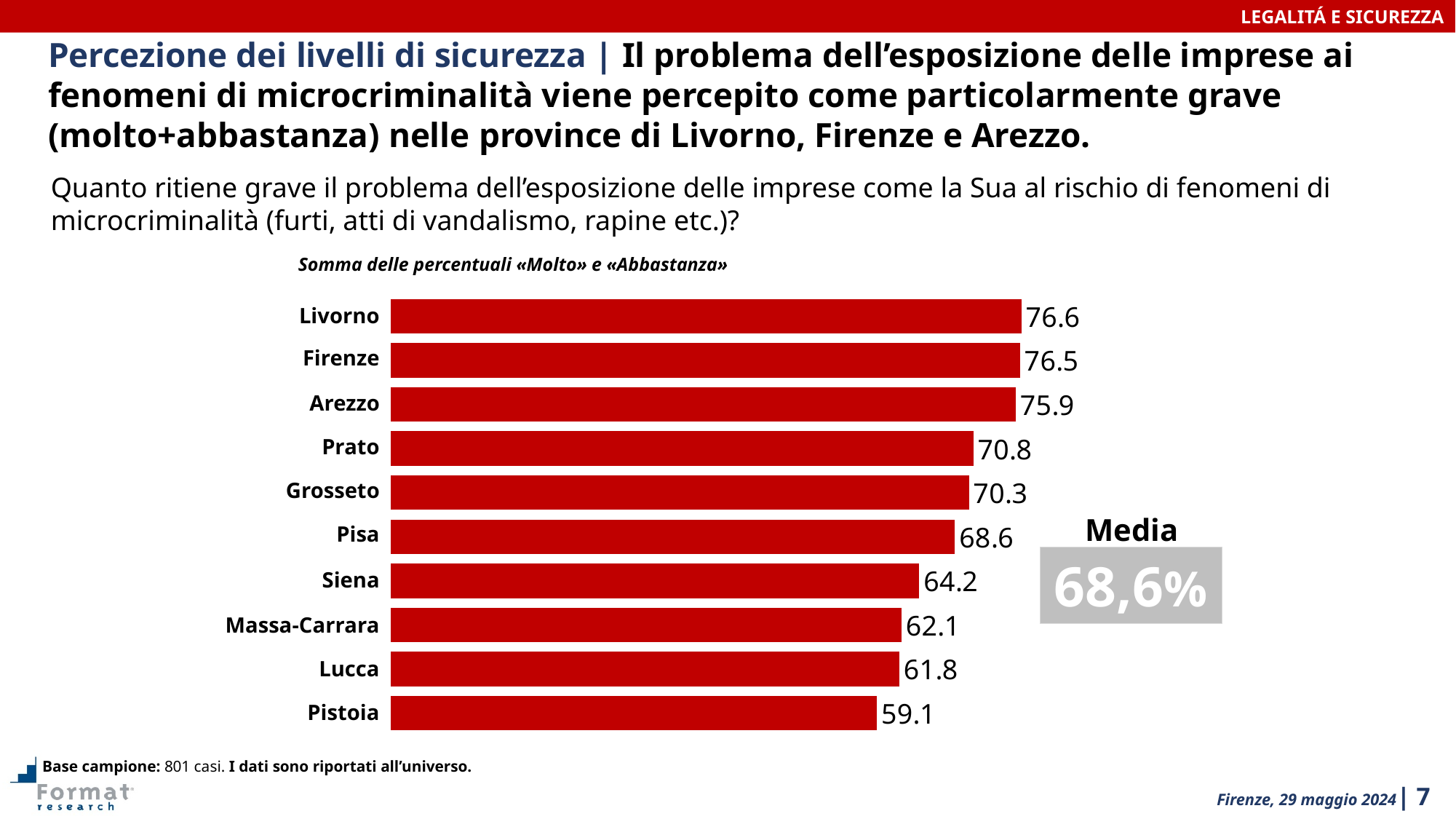
What is the difference between the values for Siena and Lucca? 2.4 What is the value for Livorno? 76.6 Do the values rise or fall going from the top bar to the bottom bar? Fall What kind of chart is shown on the slide? Bar chart How many provinces are shown in the chart? 10 What is the value for Grosseto? 70.3 Which is larger, the value for Pisa or the value for Siena? Pisa Which province has the lowest value? Pistoia What is the difference between the values for Livorno and Pistoia? 17.5 What is the 'Media' value shown next to the chart? 68,6% What is the value for Massa-Carrara? 62.1 Which province has the highest value? Livorno